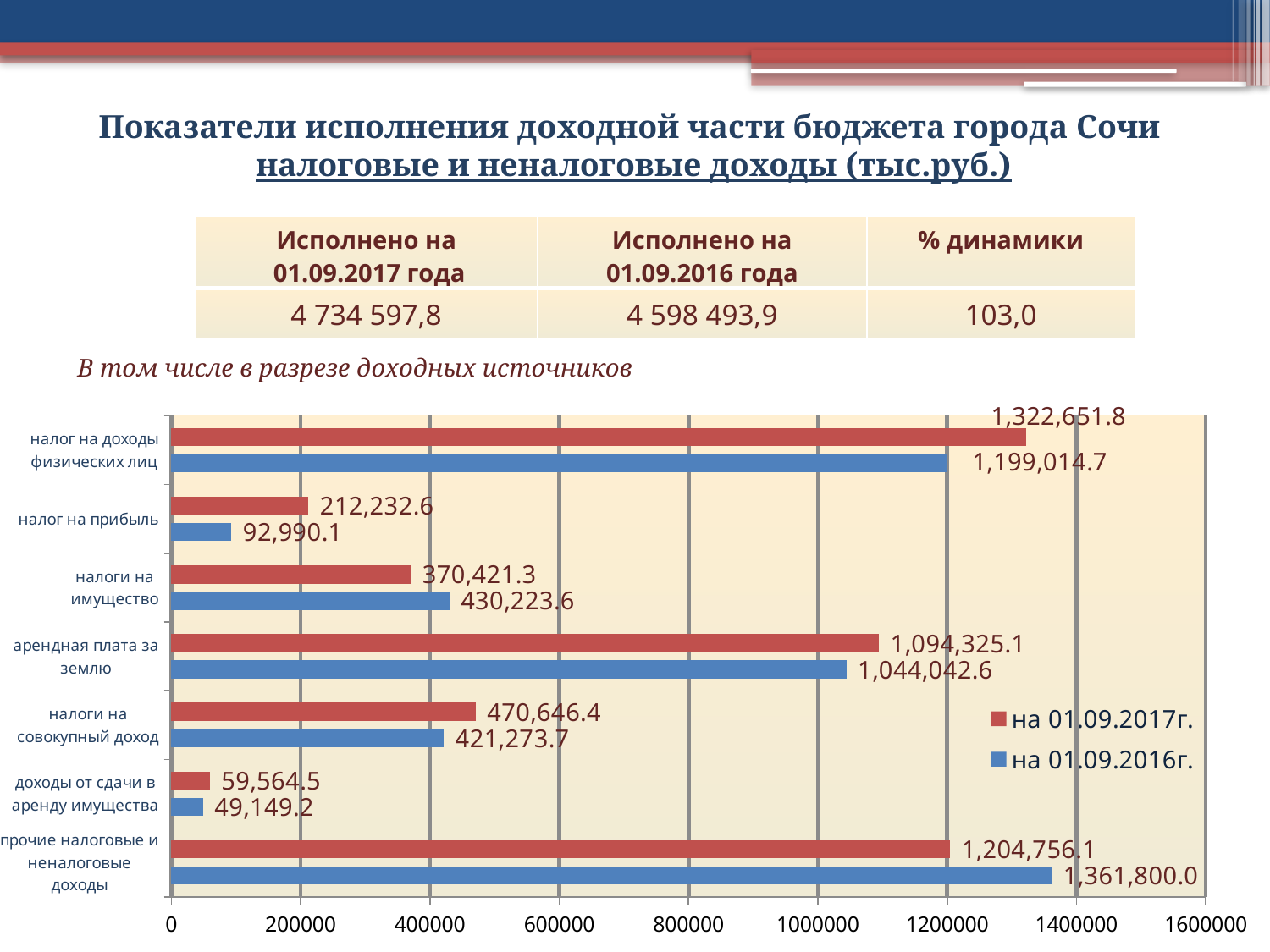
What kind of chart is shown on the slide? bar chart Is the value for налоги на совокупный доход in the series на 01.09.2017г. greater or less than 400000? greater How many series does the legend list? 2 For налоги на имущество, which series has the larger value: на 01.09.2017г. or на 01.09.2016г.? на 01.09.2016г. What is the value for арендная плата за землю in the series на 01.09.2017г.? 1,094,325.1 What is the difference between the 2017 and 2016 values for налог на доходы физических лиц? 123,637.1 What is the value for налог на прибыль in the series на 01.09.2016г.? 92,990.1 What is the difference between the 2016 and 2017 values for налоги на имущество? 59,802.3 Which category has the highest value in the series на 01.09.2016г.? прочие налоговые и неналоговые доходы What is the value for налог на доходы физических лиц in the series на 01.09.2017г.? 1,322,651.8 Which category has the lowest value in the series на 01.09.2017г.? доходы от сдачи в аренду имущества How many categories are shown on the chart? 7